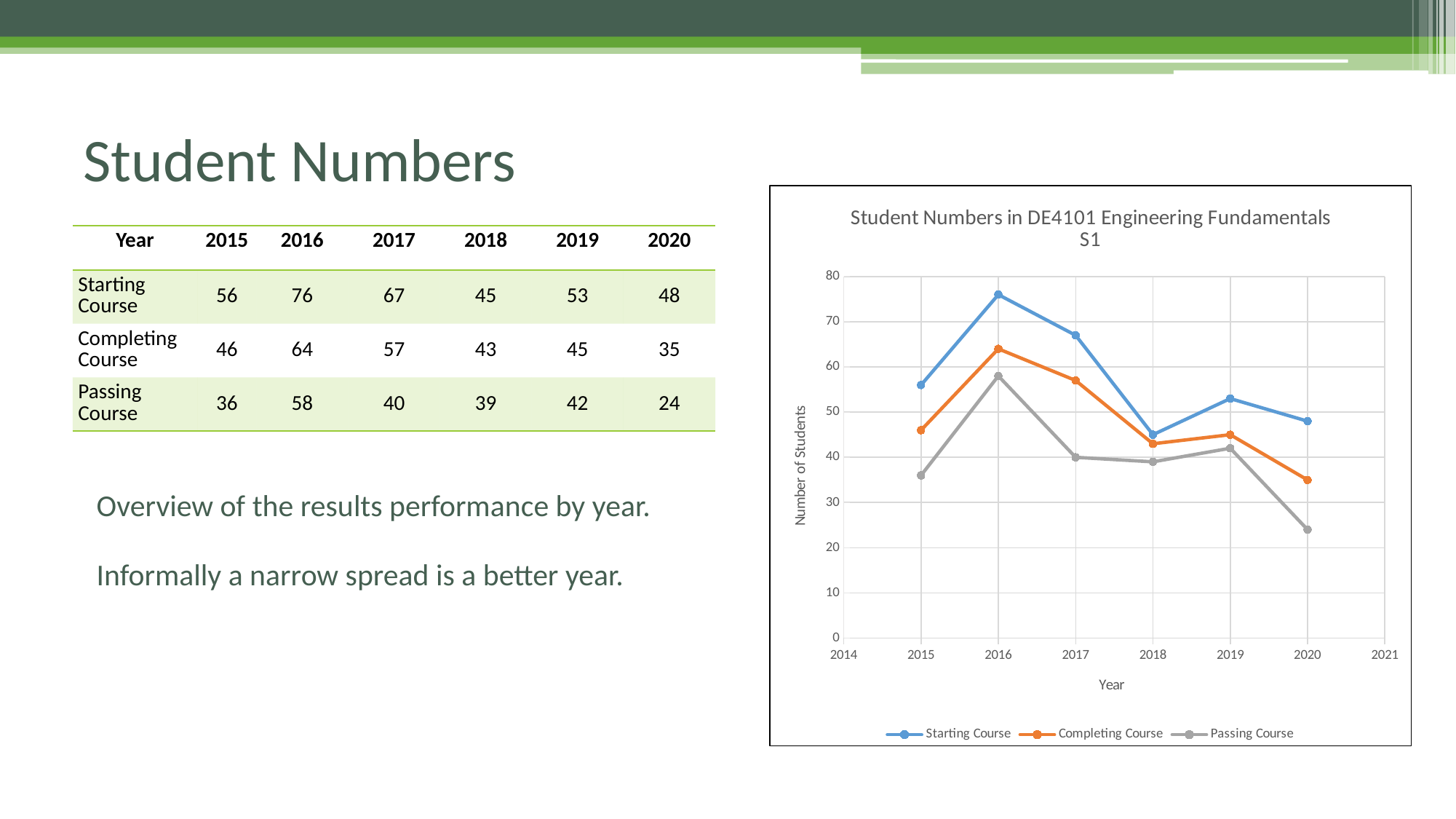
What is the difference between Starting Course and Passing Course in 2019? 11 In which year is the Starting Course value highest? 2016 How many series does the chart legend list? 3 In which year is the Passing Course value lowest? 2020 What is the value for Passing Course in 2020? 24 What is the value for Starting Course in 2016? 76 Which is larger in 2018: Completing Course or Passing Course? Completing Course Is the value for Starting Course in 2017 greater or less than 60? greater What is the value for Completing Course in 2017? 57 Does the Passing Course line rise or fall from 2019 to 2020? fall What is the title of the chart? Student Numbers in DE4101 Engineering Fundamentals S1 What type of chart is shown on the slide? line chart